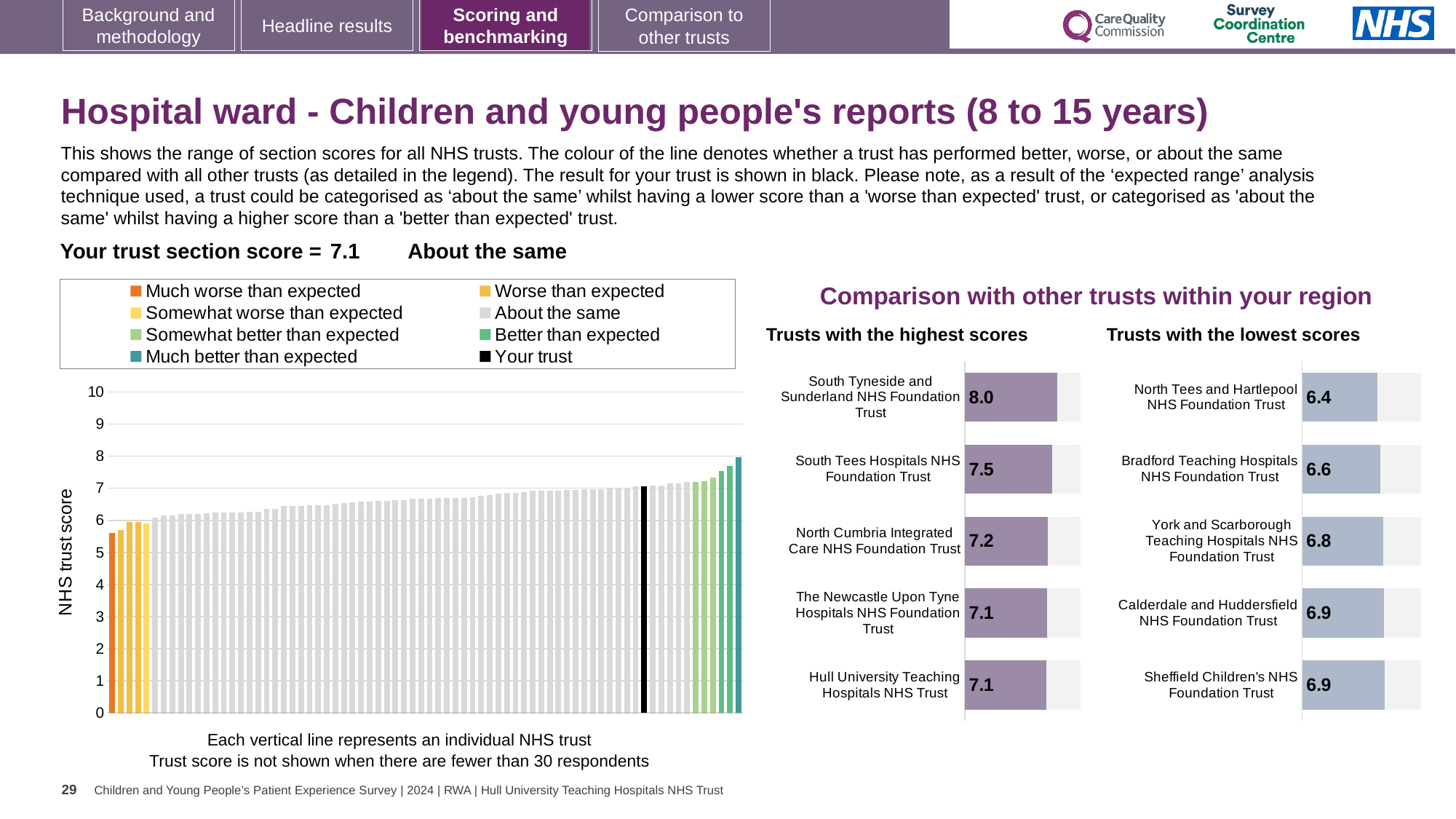
In the 'Trusts with the highest scores' chart, what is the difference between the scores of South Tyneside and Sunderland NHS Foundation Trust and South Tees Hospitals NHS Foundation Trust? 0.5 In the 'Trusts with the highest scores' chart, what is the score for North Cumbria Integrated Care NHS Foundation Trust? 7.2 In the 'Trusts with the highest scores' chart, which trust has the highest score? South Tyneside and Sunderland NHS Foundation Trust What kind of chart is the 'NHS trust score' chart on the left? bar chart In the 'Trusts with the lowest scores' chart, which trust has the lowest score? North Tees and Hartlepool NHS Foundation Trust In the 'Trusts with the lowest scores' chart, what is the score for Bradford Teaching Hospitals NHS Foundation Trust? 6.6 In the 'Trusts with the highest scores' chart, what is the score for South Tyneside and Sunderland NHS Foundation Trust? 8.0 In the 'Trusts with the lowest scores' chart, which has the larger score: Bradford Teaching Hospitals NHS Foundation Trust or York and Scarborough Teaching Hospitals NHS Foundation Trust? York and Scarborough Teaching Hospitals NHS Foundation Trust In the 'NHS trust score' chart on the left, do the bar values rise or fall from left to right? rise How many entries does the legend above the 'NHS trust score' chart list? 8 In the 'NHS trust score' chart on the left, is the value of the leftmost (orange) bar greater or less than 6? less How many trusts are listed in the 'Trusts with the lowest scores' chart? 5